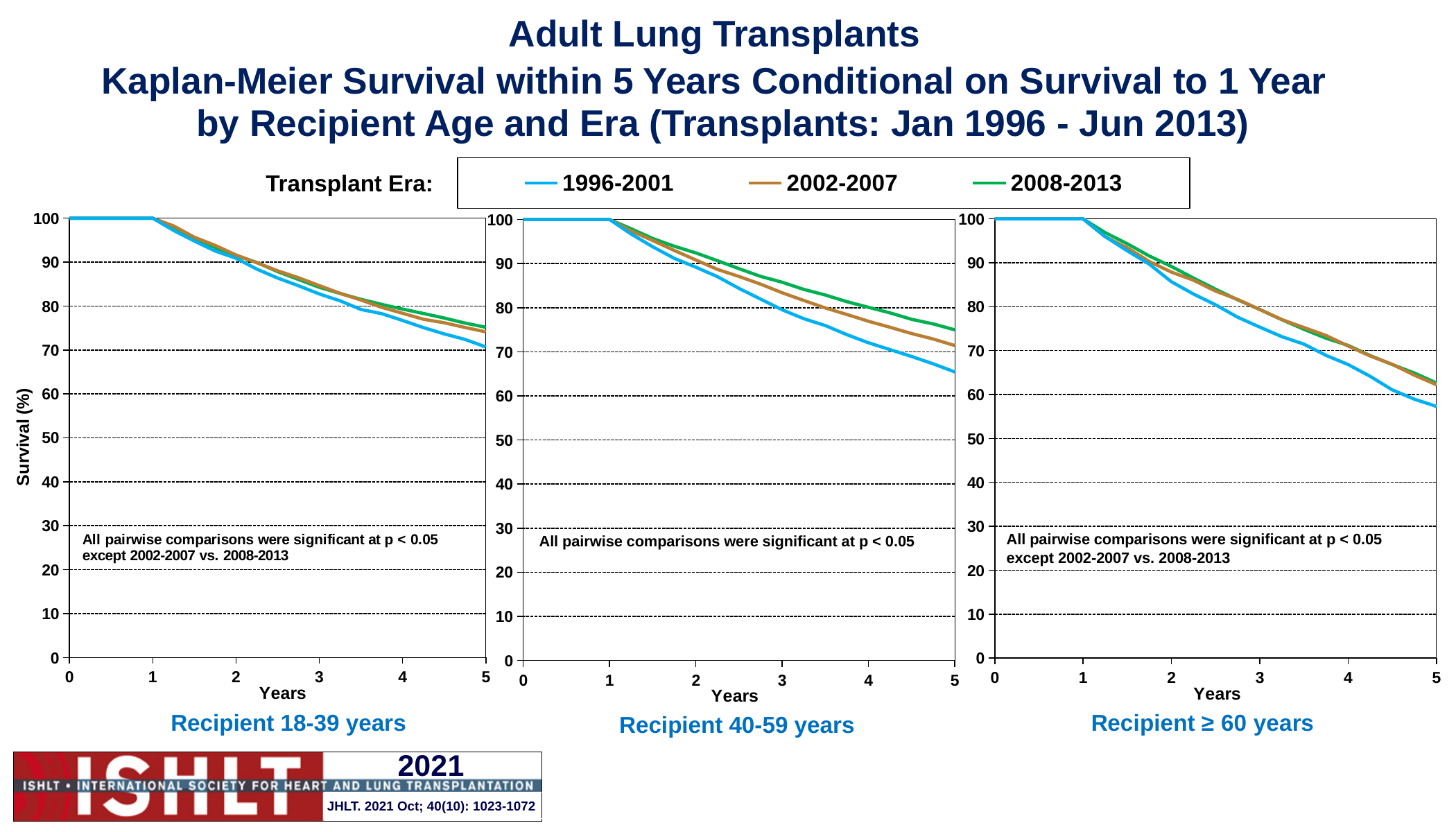
In the Recipient ≥ 60 years chart, is the 1996-2001 survival at year 5 greater or less than 60? less How many transplant eras does the legend list? 3 In the Recipient 40-59 years chart, do the survival curves rise or fall as years increase? fall In the Recipient 40-59 years chart, which era has the lowest survival at year 5? 1996-2001 In the Recipient 40-59 years chart, is the 2002-2007 survival at year 3 greater or less than 80? greater What kind of chart is used in the Recipient 18-39 years panel? line chart In the Recipient 18-39 years chart, is the 2008-2013 survival at year 5 greater or less than 70? greater What colour is the 2008-2013 line in the legend? green In the Recipient 40-59 years chart, which era has higher survival at year 5: 1996-2001 or 2008-2013? 2008-2013 How many charts are shown on the slide? 3 In the Recipient ≥ 60 years chart, what is the survival value for all eras at year 1? 100